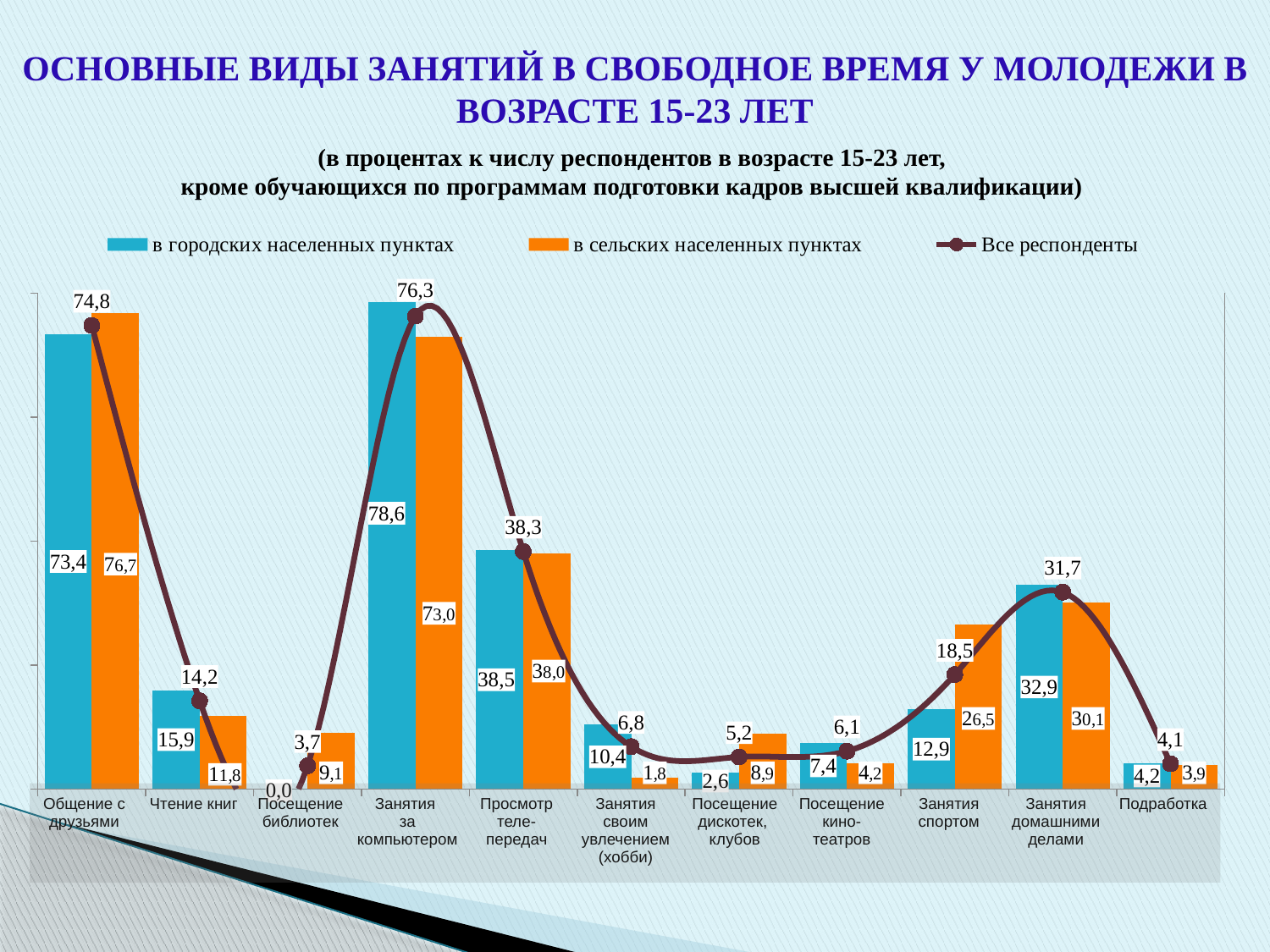
What value is shown for "в городских населенных пунктах" for "Посещение библиотек"? 0,0 Which category has the highest value for "Все респонденты"? Занятия за компьютером What value is shown for "в сельских населенных пунктах" for "Занятия спортом"? 26,5 What is the difference between the "в сельских населенных пунктах" and "в городских населенных пунктах" values for "Занятия спортом"? 13,6 Which category has the lowest value for "Все респонденты"? Посещение библиотек For "Общение с друзьями", which is larger: the value for "в городских населенных пунктах" or "в сельских населенных пунктах"? в сельских населенных пунктах How many series does the legend list? 3 Which series is drawn as a line in the chart? Все респонденты How many categories are shown on the x axis? 11 What value is shown for "в городских населенных пунктах" for "Занятия за компьютером"? 78,6 What kind of chart is shown on the slide? Combined bar and line chart What value does the "Все респонденты" line show for "Просмотр телепередач"? 38,3